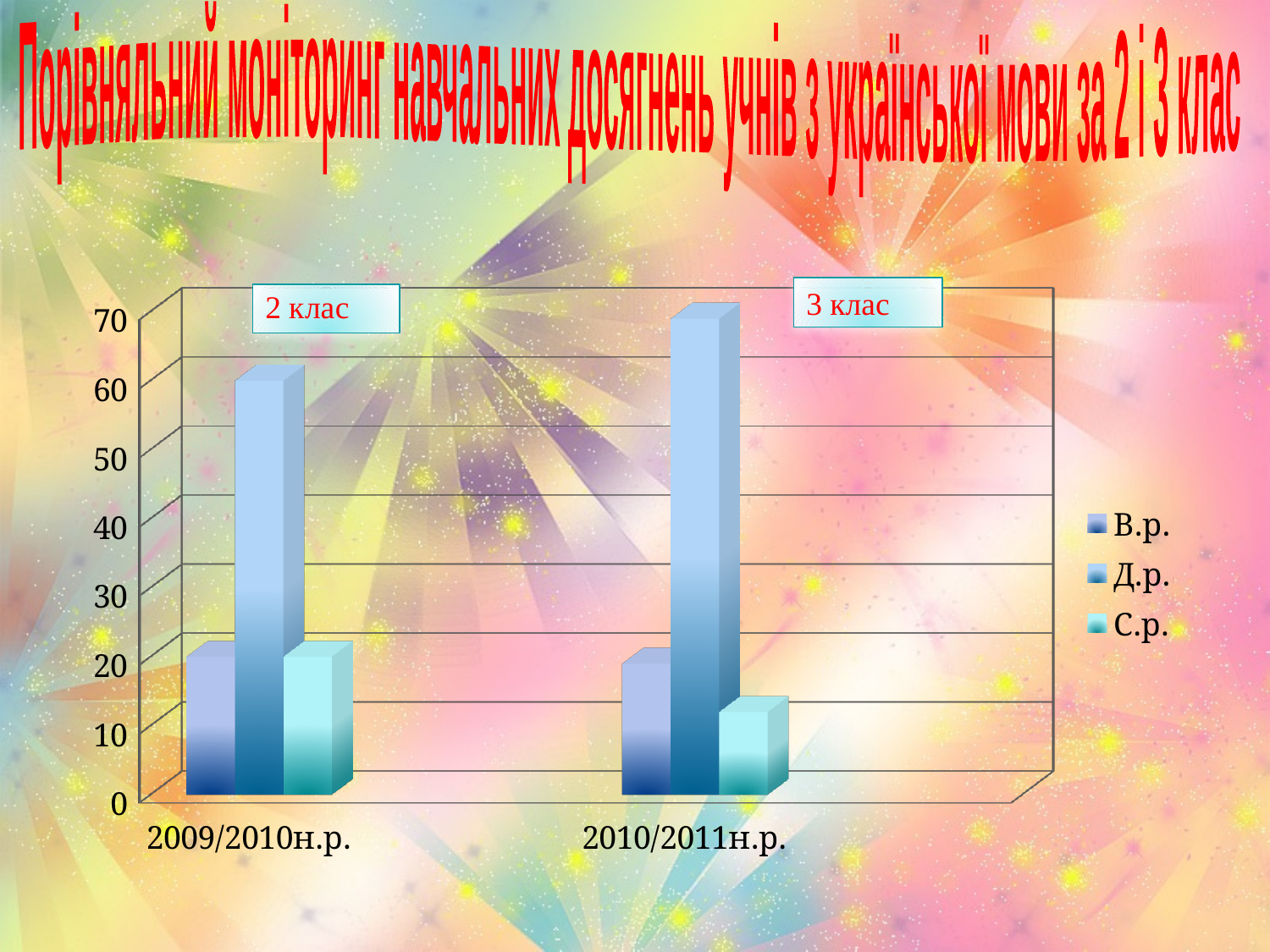
Which is larger: the Д.р. value for 2009/2010н.р. or for 2010/2011н.р.? 2010/2011н.р. How many categories are shown on the x axis? 2 How many series does the legend list? 3 Is the value of С.р. for 2010/2011н.р. greater or less than 20? less Which series has the highest value for 2009/2010н.р.? Д.р. What are the three entries listed in the legend? В.р., Д.р., С.р. Is the value of Д.р. for 2010/2011н.р. greater or less than 60? greater Which series has the lowest value for 2010/2011н.р.? С.р. Which series has the highest value for 2010/2011н.р.? Д.р. Is the value of Д.р. for 2009/2010н.р. greater or less than 50? greater Does the value of С.р. rise or fall from 2009/2010н.р. to 2010/2011н.р.? fall What kind of chart is shown on the slide? bar chart